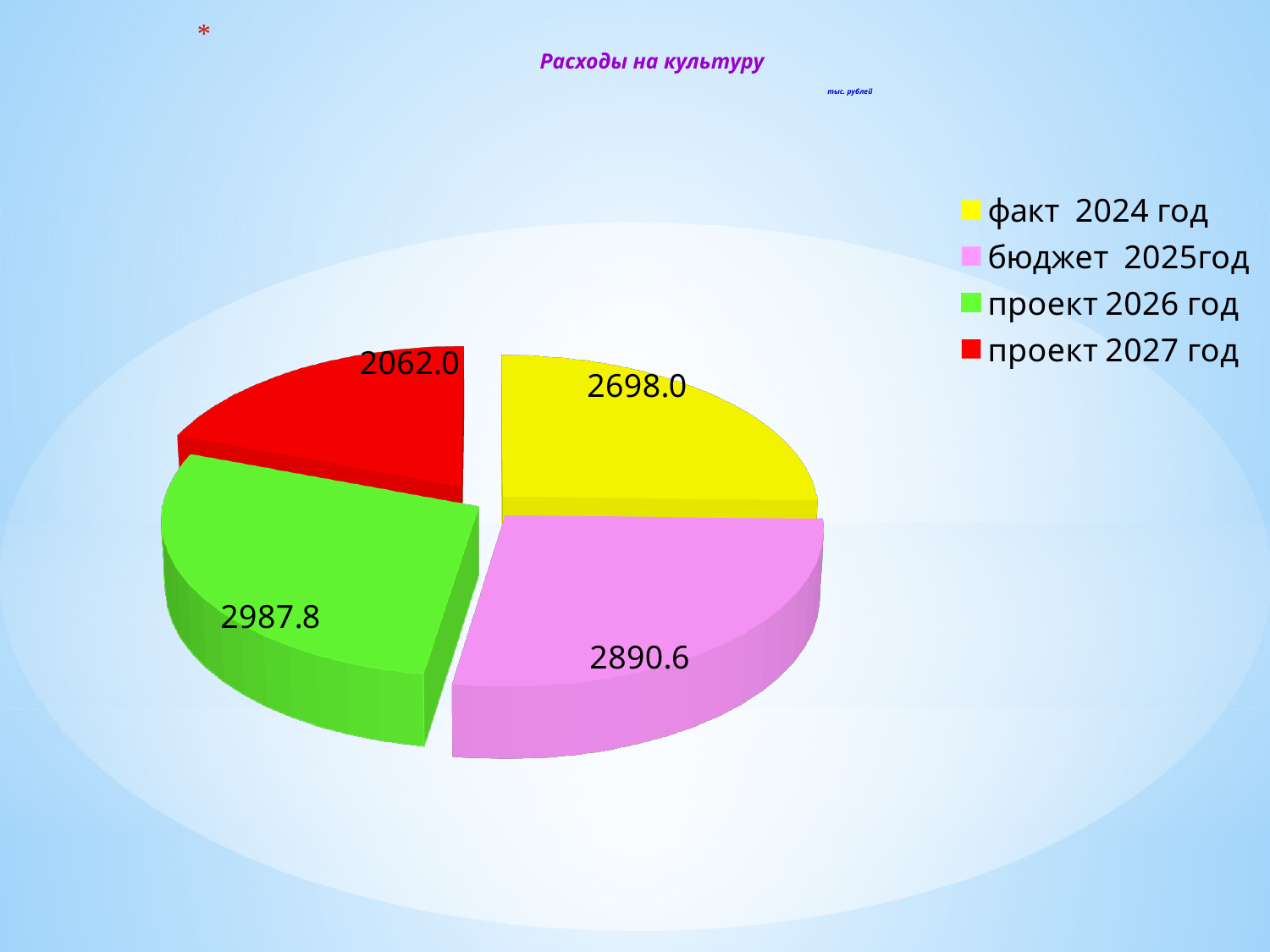
What kind of chart is shown on the slide? Pie chart What is the title of the chart? Расходы на культуру What is the value for проект 2026 год? 2987.8 What is the value for факт 2024 год? 2698.0 What is the value for проект 2027 год? 2062.0 Which category has the largest slice? проект 2026 год Which is larger, бюджет 2025год or факт 2024 год? бюджет 2025год How many entries does the legend list? 4 Which category has the smallest slice? проект 2027 год What is the difference between проект 2026 год and проект 2027 год? 925.8 What is the difference between бюджет 2025год and факт 2024 год? 192.6 What is the value for бюджет 2025год? 2890.6